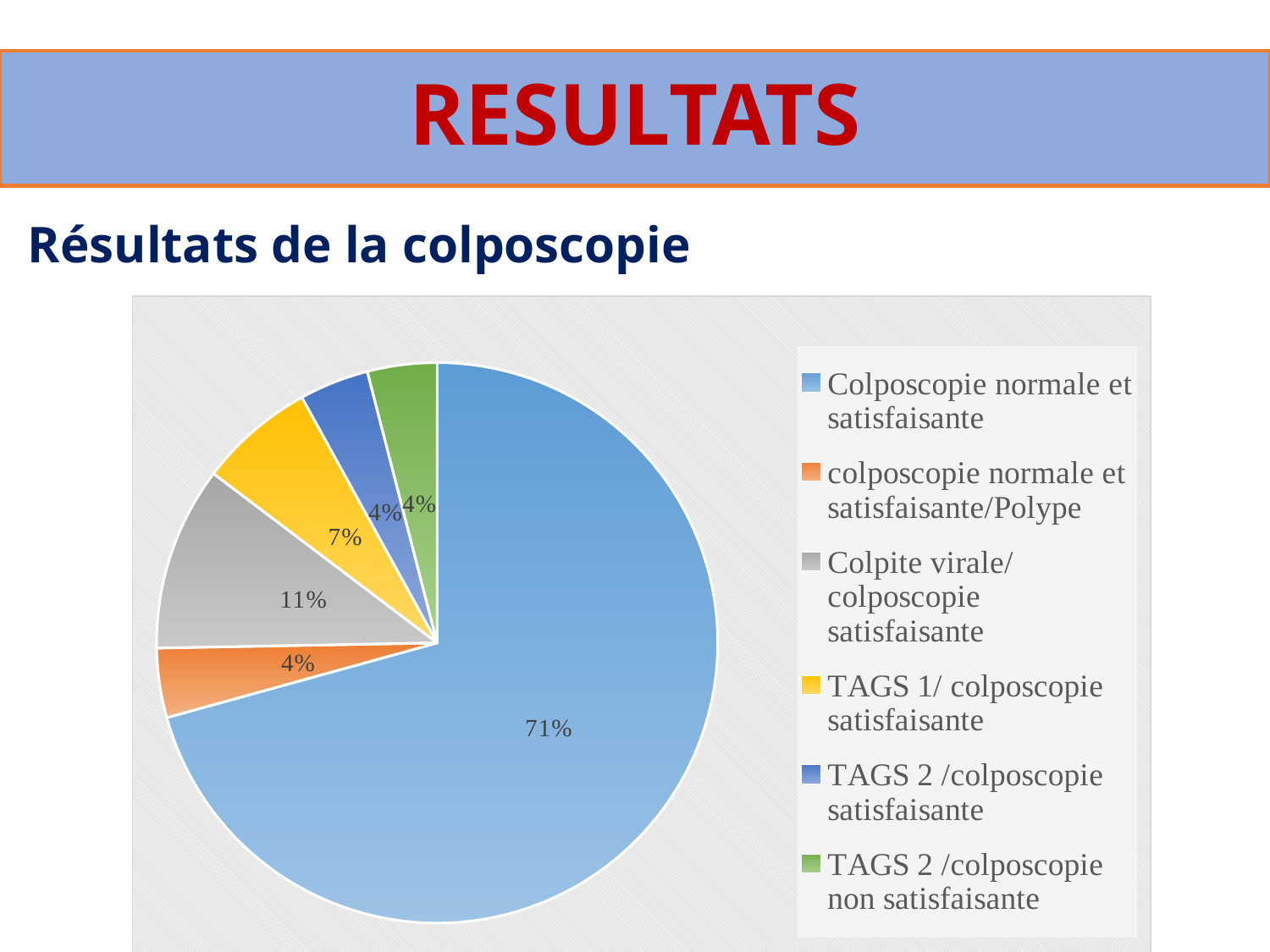
What share of the pie is 'TAGS 1/ colposcopie satisfaisante'? 7% Which category has the largest slice of the pie? Colposcopie normale et satisfaisante What is the difference between the shares of 'TAGS 1/ colposcopie satisfaisante' and 'TAGS 2 /colposcopie satisfaisante'? 3% What kind of chart is shown on the slide? pie chart Which is larger: the share of 'Colpite virale/ colposcopie satisfaisante' or the share of 'TAGS 1/ colposcopie satisfaisante'? Colpite virale/ colposcopie satisfaisante What share of the pie is 'TAGS 2 /colposcopie non satisfaisante'? 4% What colour is the slice for 'Colpite virale/ colposcopie satisfaisante'? gray What is the difference between the shares of 'Colposcopie normale et satisfaisante' and 'Colpite virale/ colposcopie satisfaisante'? 60% What share of the pie is 'Colposcopie normale et satisfaisante'? 71% How many categories does the legend list? 6